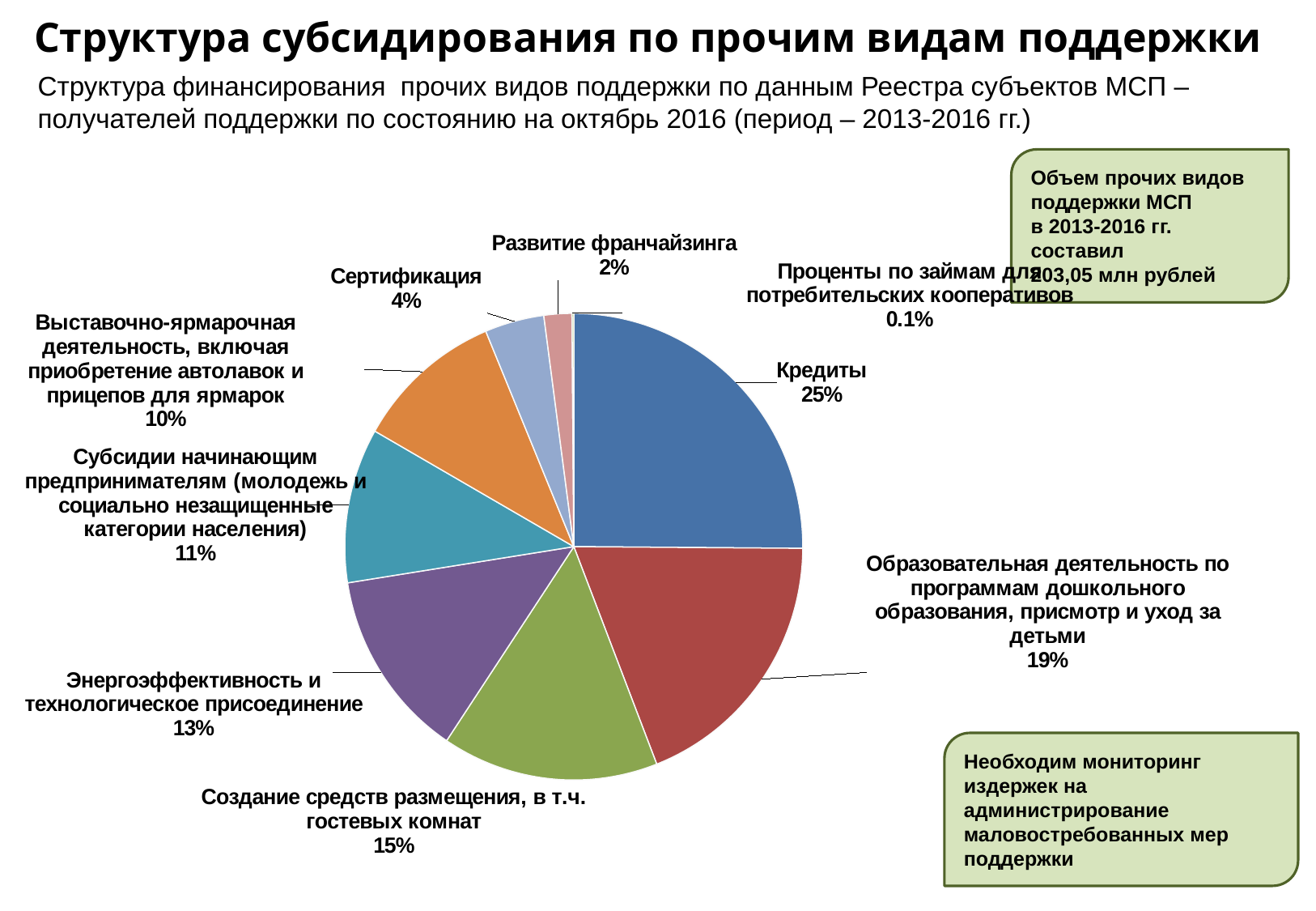
What kind of chart is shown on the slide? pie chart Which category has the smallest share of the pie? Проценты по займам для потребительских кооперативов Which is larger: the share for "Субсидии начинающим предпринимателям" or the share for "Выставочно-ярмарочная деятельность"? Субсидии начинающим предпринимателям Which category has the largest share of the pie? Кредиты What share of the pie does "Кредиты" have? 25% What percentage is shown for "Проценты по займам для потребительских кооперативов"? 0.1% What percentage is shown for "Развитие франчайзинга"? 2% What is the difference in percentage points between "Кредиты" and "Создание средств размещения, в т.ч. гостевых комнат"? 10 How many categories (slices) does the pie chart have? 9 What percentage is shown for "Сертификация"? 4% What is the title of the slide containing the pie chart? Структура субсидирования по прочим видам поддержки What percentage is shown for "Энергоэффективность и технологическое присоединение"? 13%